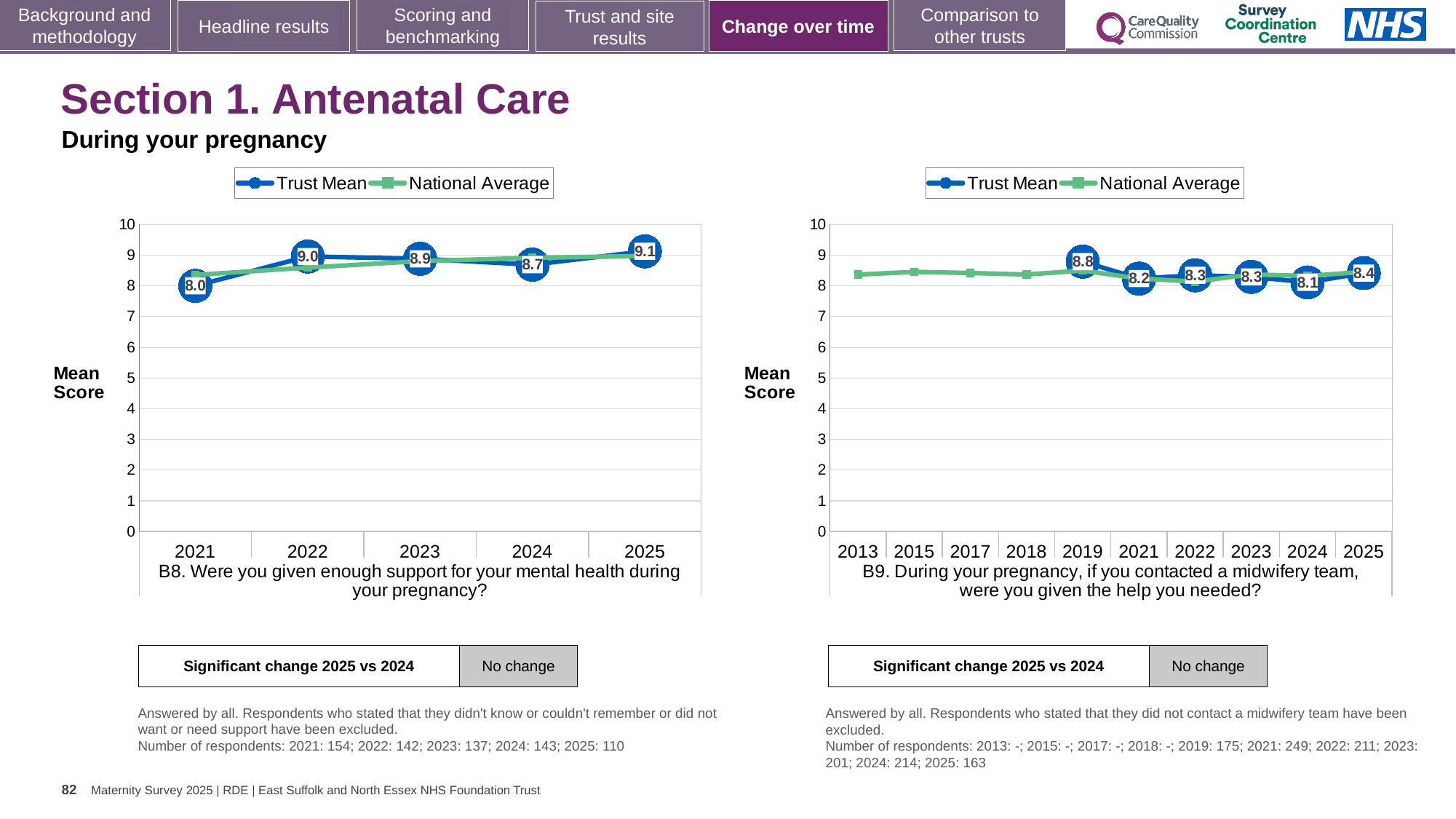
In the B9 chart on the right, is the Trust Mean for 2025 larger or smaller than for 2024? larger How many series does the legend of the B9 chart on the right list? 2 What kind of chart is the B8 chart on the left? line chart In the B8 chart on the left, how many years are shown on the x axis? 5 In the B9 chart on the right, which year has the highest Trust Mean? 2019 In the B8 chart on the left, which year has the lowest Trust Mean? 2021 In the B9 chart on the right, is the National Average for 2013 greater or less than 9? less In the B8 chart on the left, what is the difference between the Trust Mean in 2022 and in 2021? 1.0 In the B8 chart on the left, what is the Trust Mean for 2021? 8.0 In the B9 chart on the right, what is the Trust Mean for 2024? 8.1 In the B8 chart on the left, what is the Trust Mean for 2025? 9.1 In the B9 chart on the right, what is the Trust Mean for 2019? 8.8